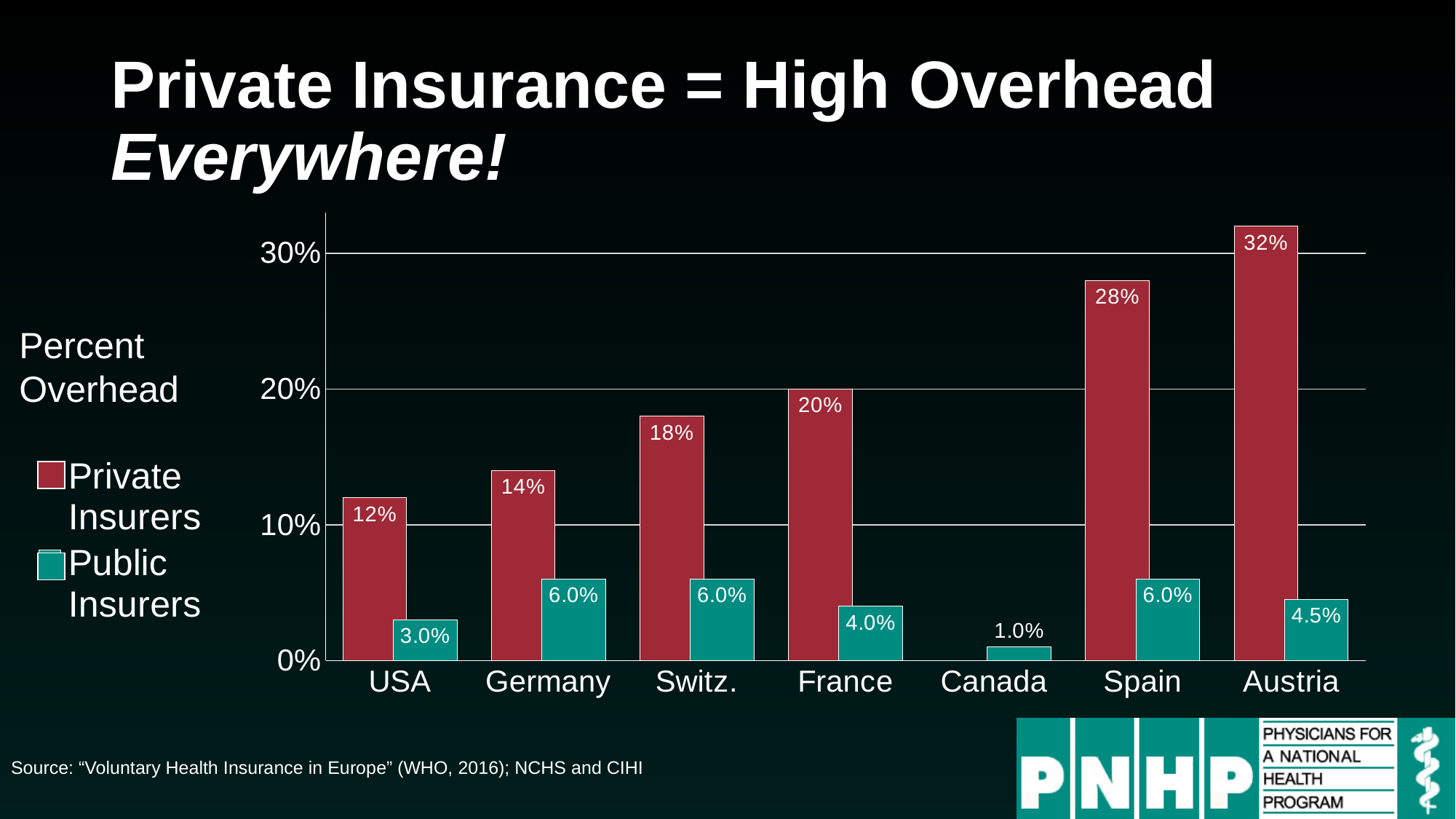
What is the Public Insurers overhead value for Canada? 1.0% What is the difference between the Private Insurers and Public Insurers overhead for France? 16% What kind of chart is shown on the slide? Bar chart What is the Private Insurers overhead value for Spain? 28% Which country has the highest Private Insurers overhead? Austria What is the Public Insurers overhead value for Austria? 4.5% Which is larger, the Private Insurers overhead for Germany or for Switzerland? Switzerland Which country has the lowest Public Insurers overhead? Canada Is the Private Insurers value for Austria greater or less than 30%? greater What colour represents Public Insurers in the chart? Teal How many series does the legend list? 2 How many countries are shown on the x axis? 7